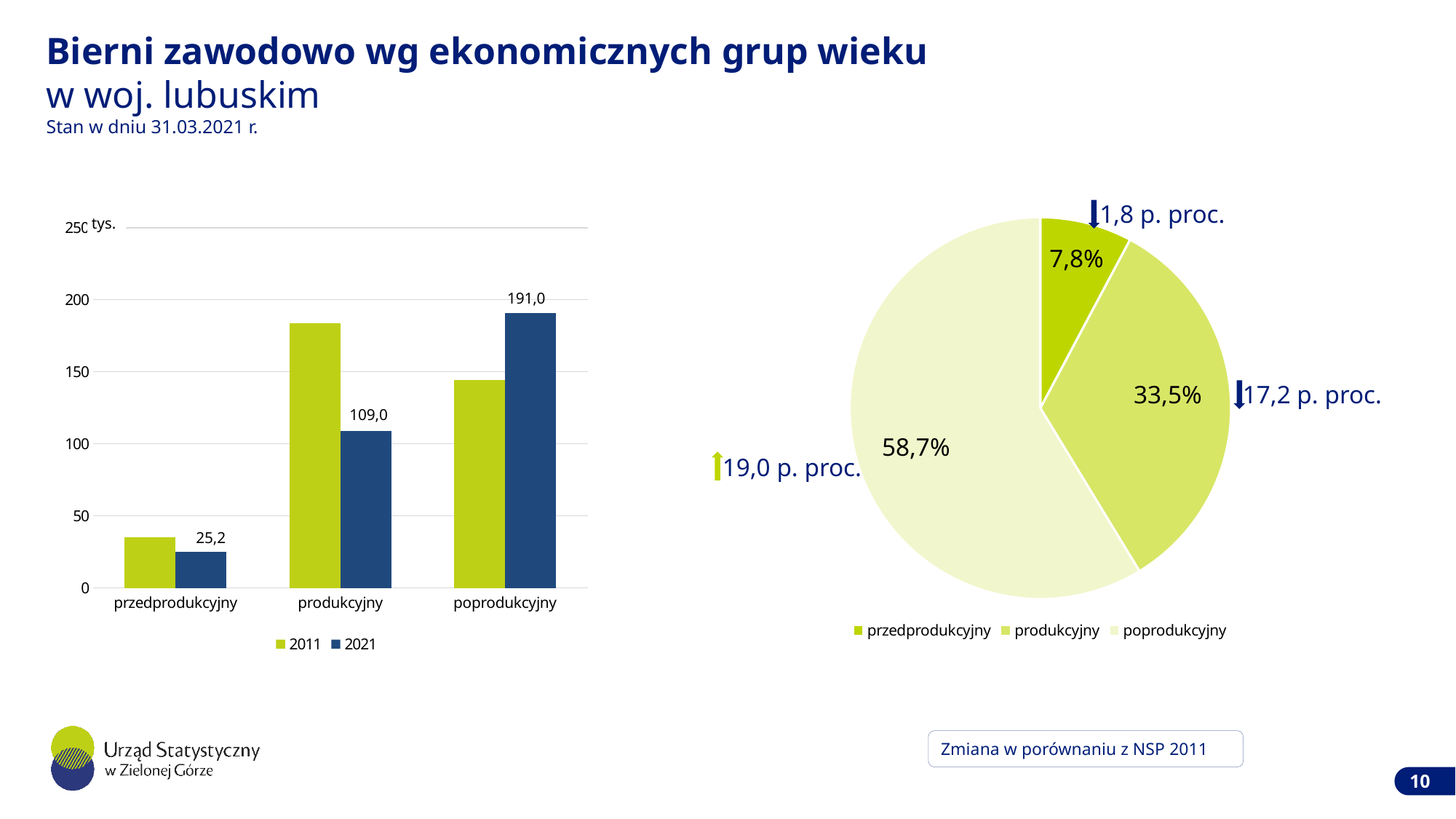
In the bar chart on the left, which category has the lowest 2011 value? przedprodukcyjny In the pie chart on the right, what share does poprodukcyjny have? 58,7% What kind of chart is shown on the right side of the slide? pie chart In the bar chart on the left, what is the 2021 value for przedprodukcyjny? 25,2 In the bar chart on the left, which is larger for produkcyjny: the 2011 value or the 2021 value? 2011 In the bar chart on the left, is the 2011 value for produkcyjny greater or less than 150? greater In the pie chart on the right, which category has the smallest slice? przedprodukcyjny How many series does the legend of the bar chart on the left list? 2 In the bar chart on the left, what is the 2021 value for produkcyjny? 109,0 In the bar chart on the left, what is the 2021 value for poprodukcyjny? 191,0 In the bar chart on the left, which category has the highest 2021 value? poprodukcyjny In the bar chart on the left, what is the difference between the 2021 values for poprodukcyjny and produkcyjny? 82,0